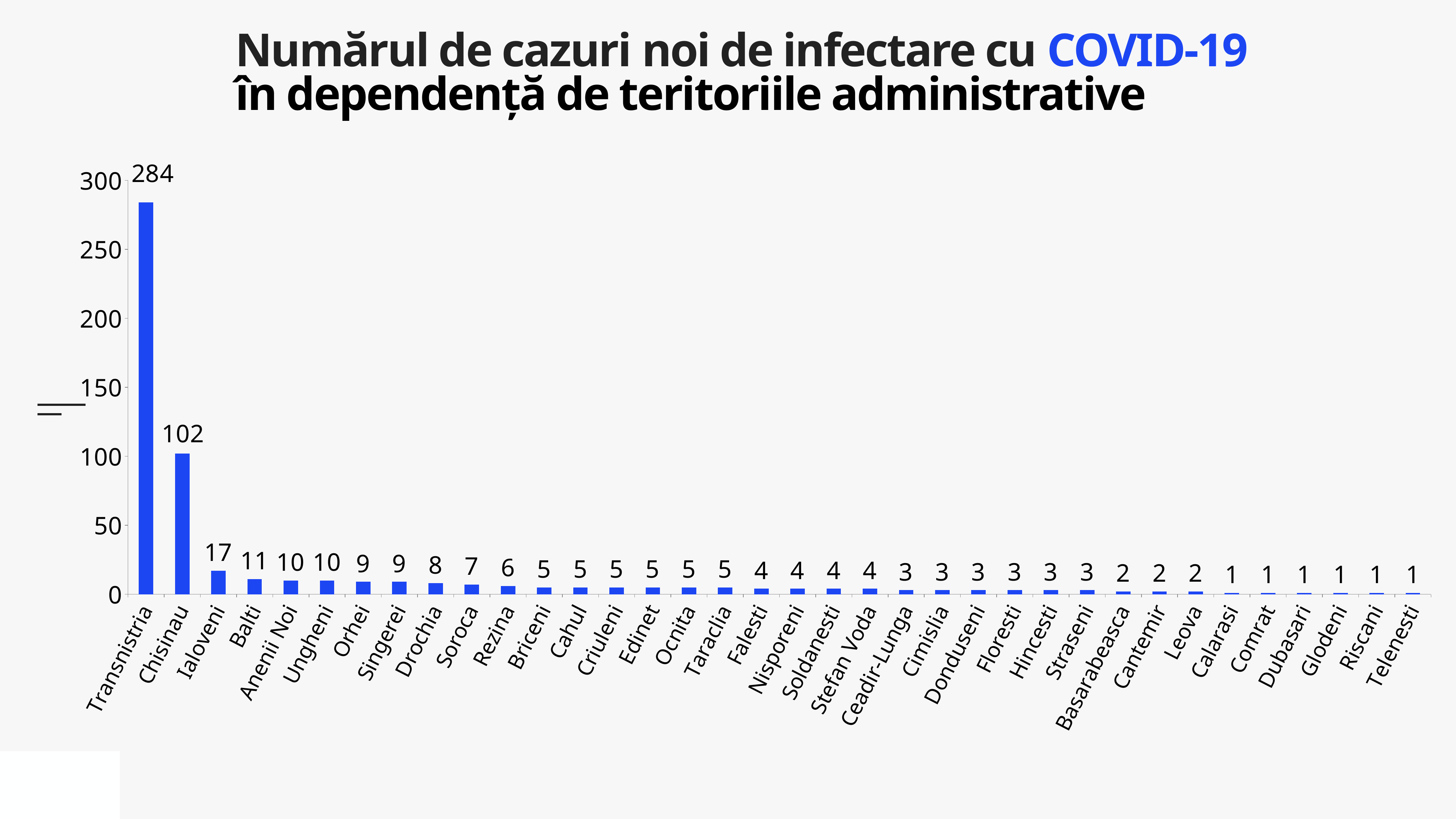
Which has a larger value, Drochia or Rezina? Drochia What is the difference between the values for Transnistria and Chisinau? 182 What is the value for Chisinau? 102 What kind of chart is shown on the slide? bar chart Which territory has the highest number of new cases? Transnistria What is the value for Balti? 11 How many territories are shown on the x axis? 36 What is the difference between the values for Ialoveni and Balti? 6 What is the value for Ialoveni? 17 What is the value for Soroca? 7 What is the value for Transnistria? 284 Is the value for Chisinau greater or less than 150? less